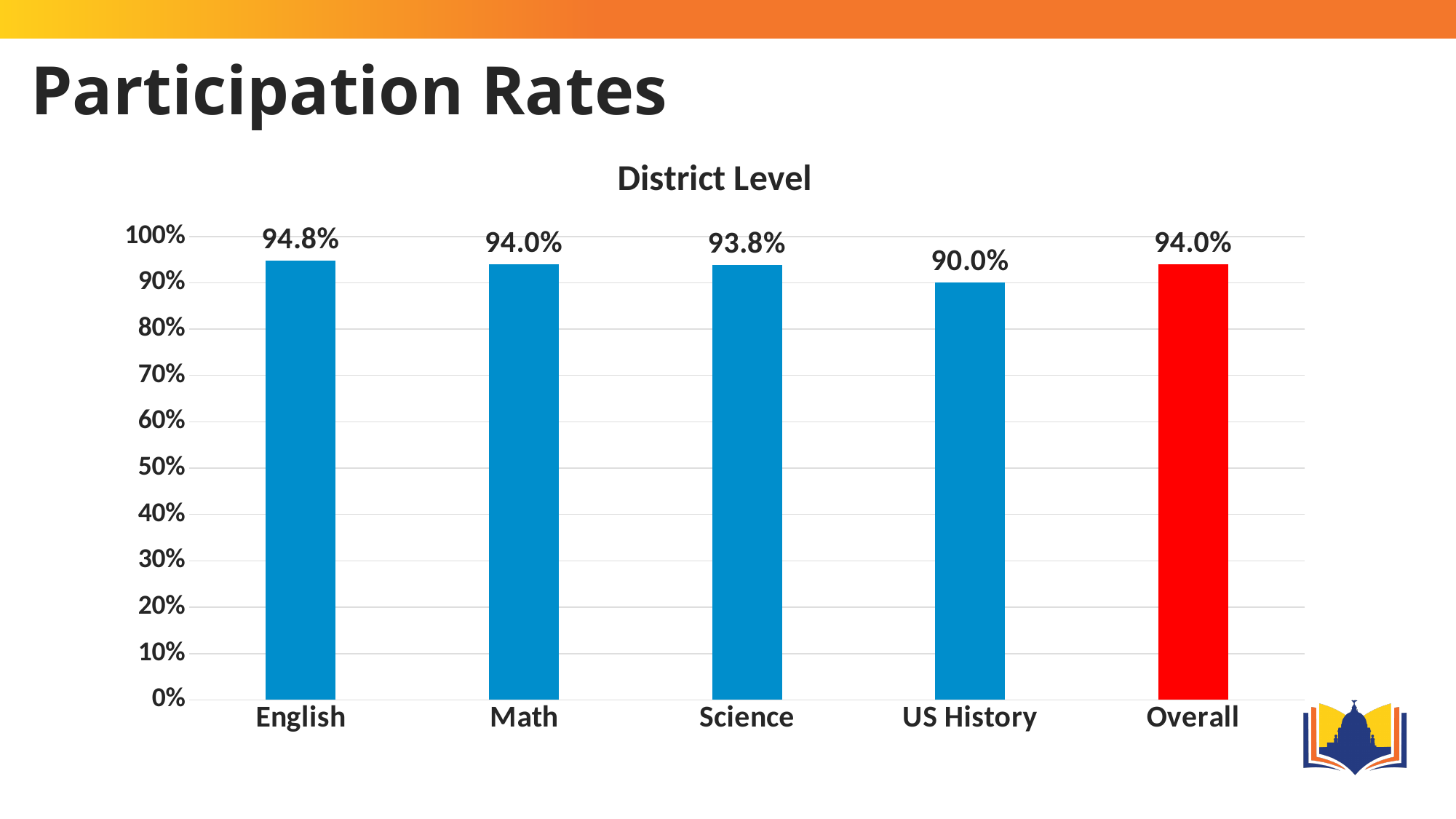
Which has a higher participation rate, English or US History? English What kind of chart is shown on the slide? Bar chart What is the title of the chart? District Level What is the Overall participation rate? 94.0% What is the difference between the English and US History participation rates? 4.8% What is the difference between the Math and Science participation rates? 0.2% What is the participation rate for English? 94.8% What is the participation rate for Science? 93.8% What is the participation rate for US History? 90.0% Which category has the highest participation rate? English How many categories are shown on the chart? 5 Which category has the lowest participation rate? US History